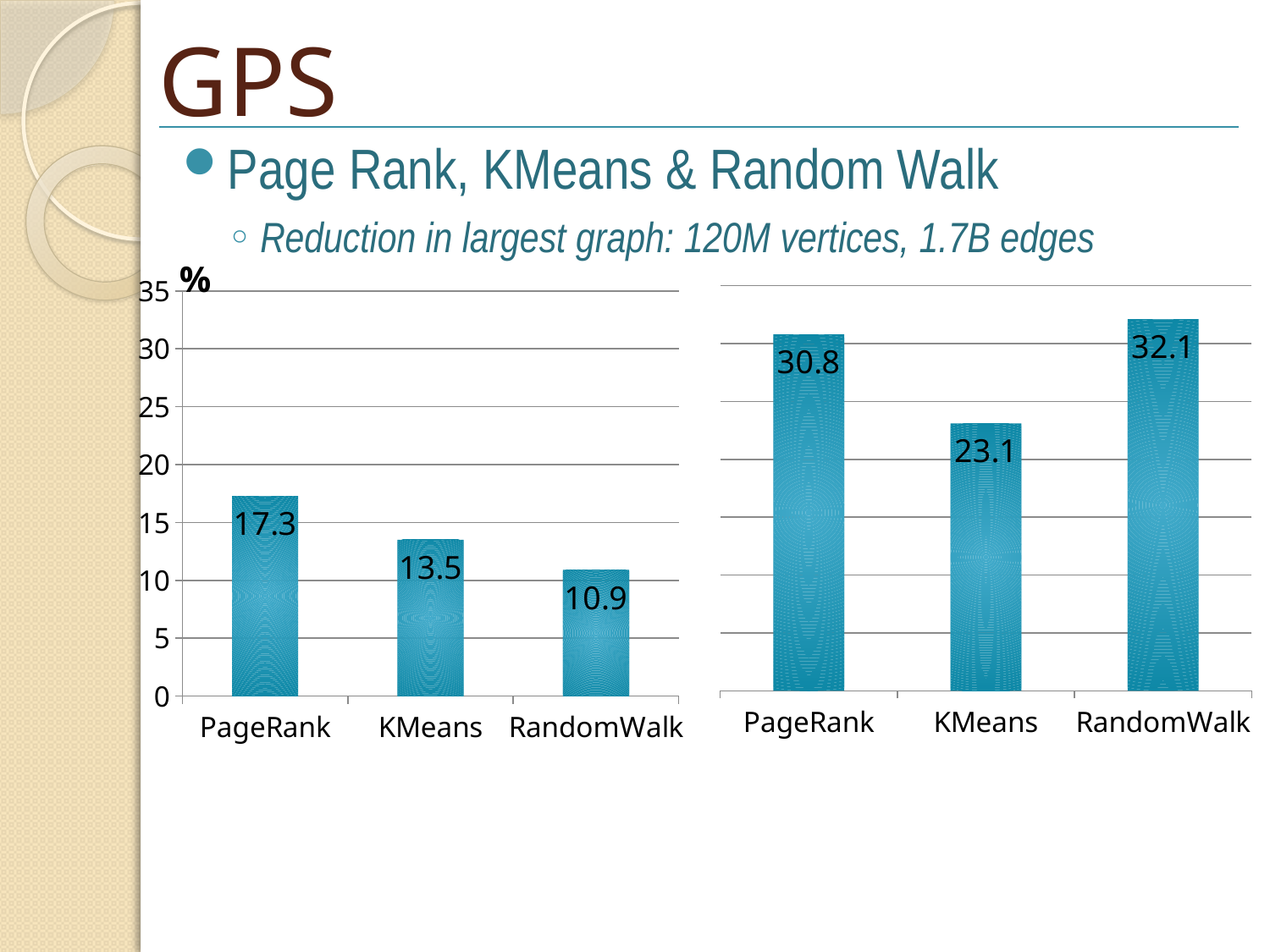
In the left chart, what is the difference between the PageRank and KMeans values? 3.8 In the right chart, which is larger, the value for PageRank or the value for KMeans? PageRank How many categories does the left chart show? 3 In the right chart, what is the value for RandomWalk? 32.1 In the right chart, what is the difference between the RandomWalk and PageRank values? 1.3 In the right chart, which category has the lowest value? KMeans In the left chart, what is the value for RandomWalk? 10.9 In the left chart, what is the value for PageRank? 17.3 In the left chart, which category has the highest value? PageRank What kind of chart is the right chart? bar chart In the left chart, do the values rise or fall from PageRank to RandomWalk? fall In the right chart, what is the value for KMeans? 23.1